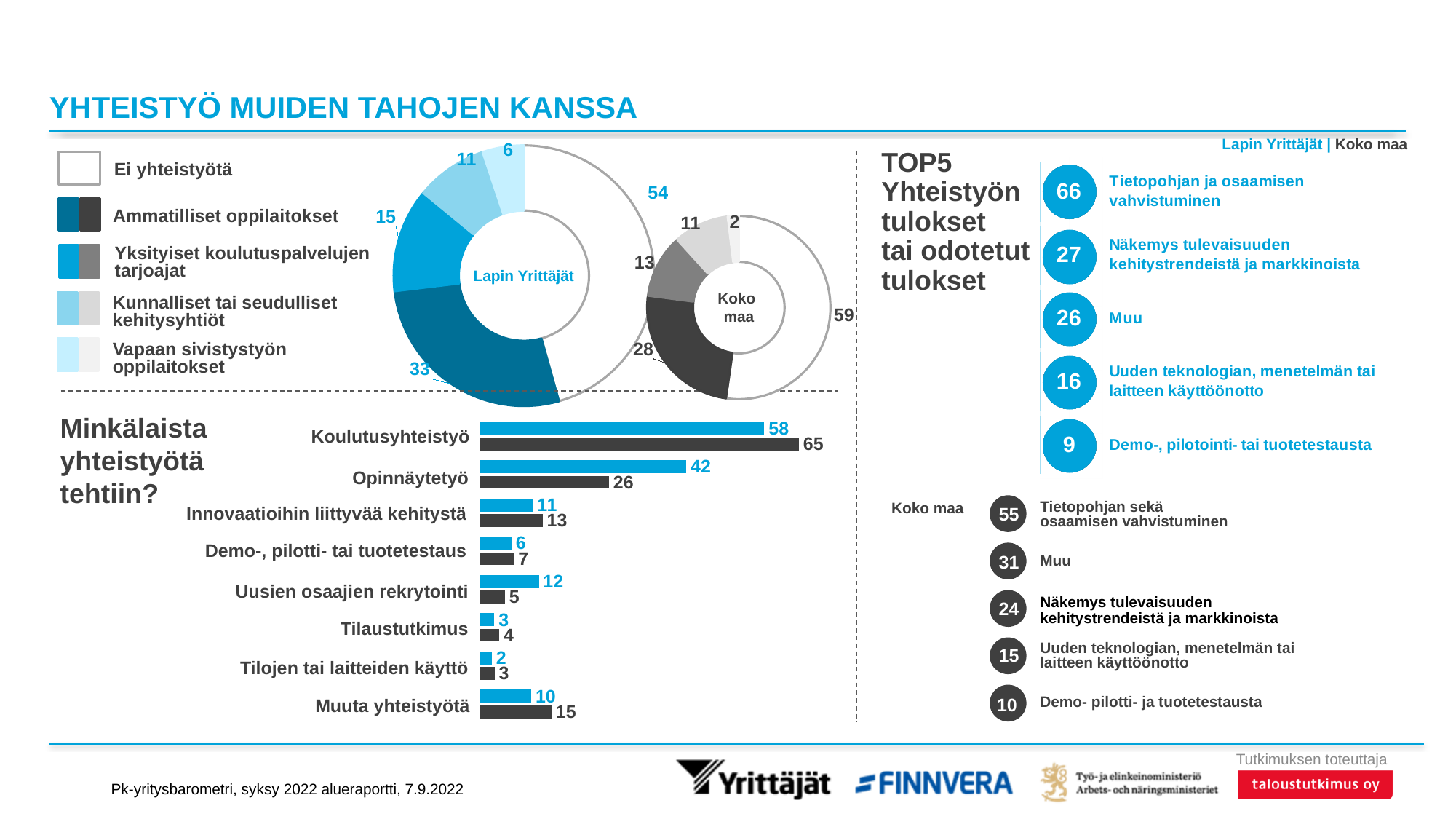
How many entries does the legend of the donut charts list? 5 In the bar chart 'Minkälaista yhteistyötä tehtiin?', what is the difference between the Koko maa and Lapin Yrittäjät values for Koulutusyhteistyö? 7 In the Lapin Yrittäjät donut chart, what is the value for Ei yhteistyötä? 54 In the bar chart 'Minkälaista yhteistyötä tehtiin?', what is the Lapin Yrittäjät value for Koulutusyhteistyö? 58 How many categories does the bar chart 'Minkälaista yhteistyötä tehtiin?' show? 8 In the bar chart 'Minkälaista yhteistyötä tehtiin?', which is larger for Uusien osaajien rekrytointi: the Lapin Yrittäjät value or the Koko maa value? Lapin Yrittäjät In the Koko maa donut chart, what is the value for Ammatilliset oppilaitokset? 28 In the bar chart 'Minkälaista yhteistyötä tehtiin?', what is the Koko maa value for Opinnäytetyö? 26 In the Lapin Yrittäjät donut chart, which segment is the smallest? Vapaan sivistystyön oppilaitokset In the bar chart 'Minkälaista yhteistyötä tehtiin?', which category has the highest Koko maa value? Koulutusyhteistyö In the bar chart 'Minkälaista yhteistyötä tehtiin?', which category has the lowest Lapin Yrittäjät value? Tilojen tai laitteiden käyttö What type of chart is 'Minkälaista yhteistyötä tehtiin?'? bar chart